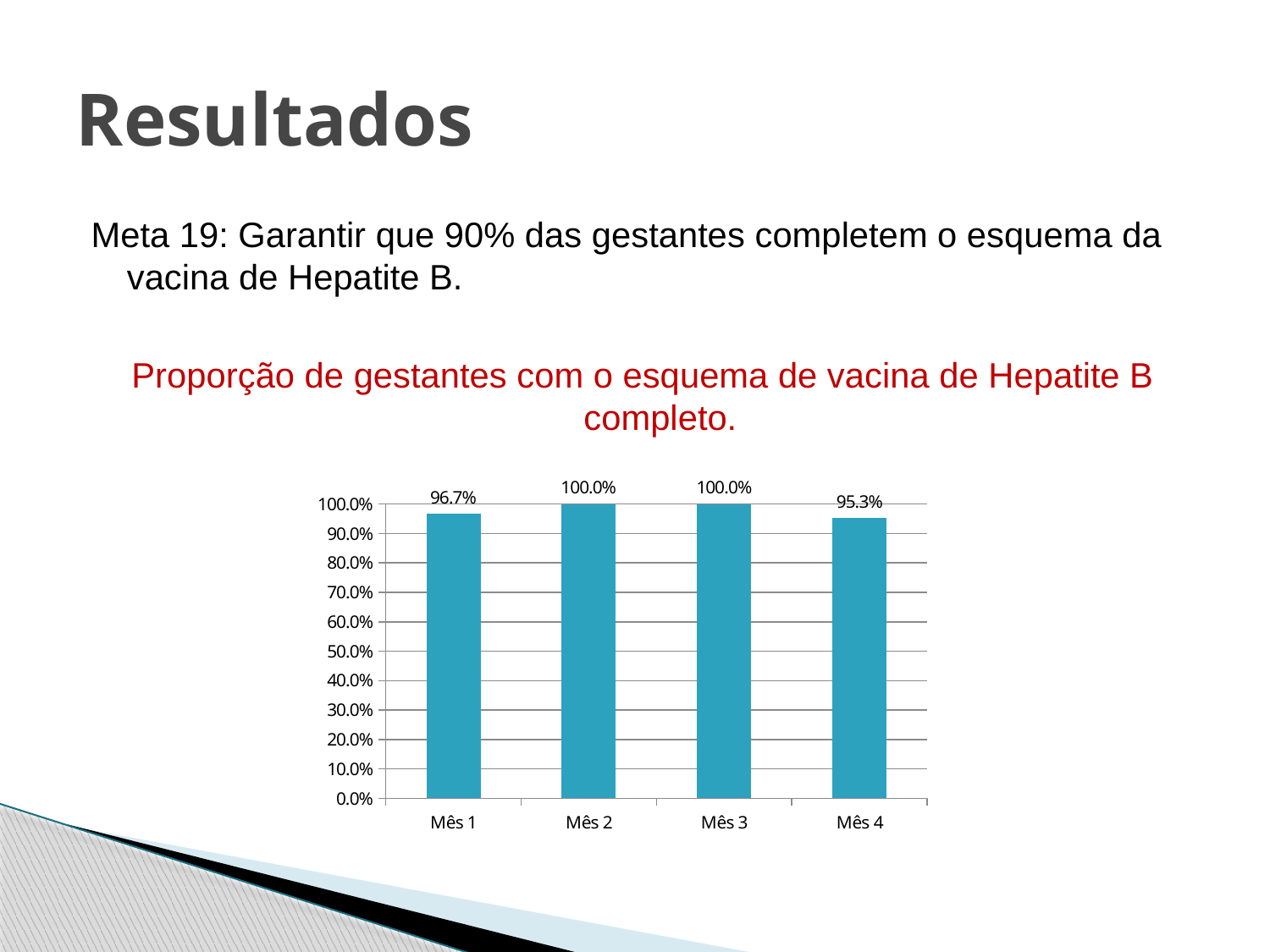
How many categories are shown on the x axis? 4 What is the difference between the values for Mês 1 and Mês 4? 1.4% What is the value for Mês 2? 100.0% What is the title of the chart? Proporção de gestantes com o esquema de vacina de Hepatite B completo. What is the value for Mês 1? 96.7% Which is larger, the value for Mês 1 or the value for Mês 4? Mês 1 What kind of chart is shown on the slide? bar chart Is the value for Mês 4 greater or less than 90.0%? greater What is the value for Mês 4? 95.3% How many categories reach 100.0%? 2 What is the difference between the values for Mês 2 and Mês 1? 3.3% Which category has the lowest value? Mês 4